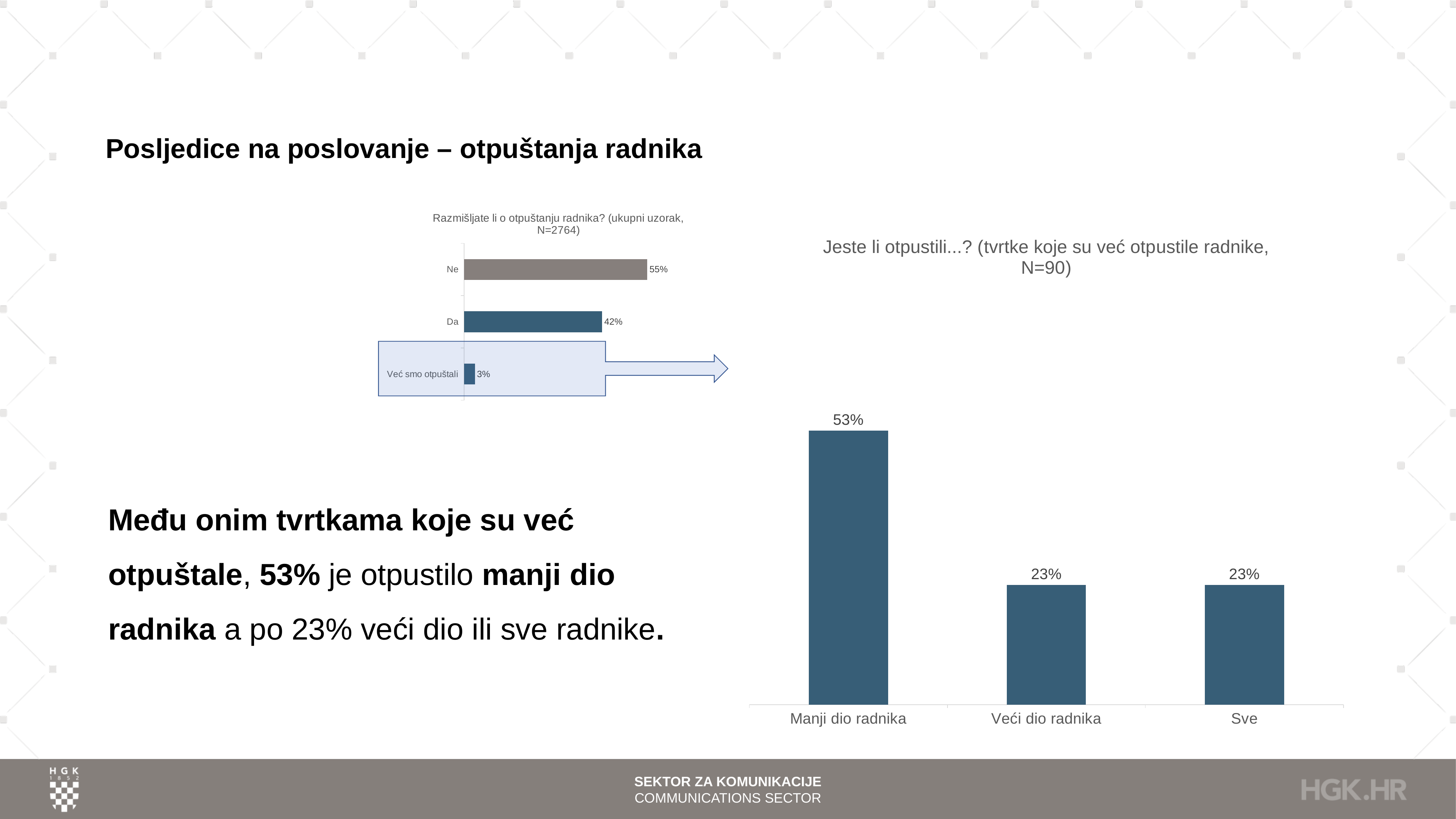
In the left chart 'Razmišljate li o otpuštanju radnika?', what is the value for 'Da'? 42% In the right chart 'Jeste li otpustili...?', which category has the highest value? Manji dio radnika In the left chart 'Razmišljate li o otpuštanju radnika?', which category has the lowest value? Već smo otpuštali In the left chart 'Razmišljate li o otpuštanju radnika?', what is the difference between the values for 'Ne' and 'Da'? 13% In the left chart 'Razmišljate li o otpuštanju radnika?', how many categories are shown? 3 What kind of chart is the right chart 'Jeste li otpustili...?'? Bar chart In the left chart 'Razmišljate li o otpuštanju radnika?', what is the value for 'Već smo otpuštali'? 3% In the right chart 'Jeste li otpustili...?', what is the value for 'Manji dio radnika'? 53% In the right chart 'Jeste li otpustili...?', what is the value for 'Sve'? 23% In the left chart 'Razmišljate li o otpuštanju radnika?', which category has the highest value? Ne In the right chart 'Jeste li otpustili...?', what is the difference between the values for 'Manji dio radnika' and 'Veći dio radnika'? 30% In the left chart 'Razmišljate li o otpuštanju radnika?', what is the value for 'Ne'? 55%